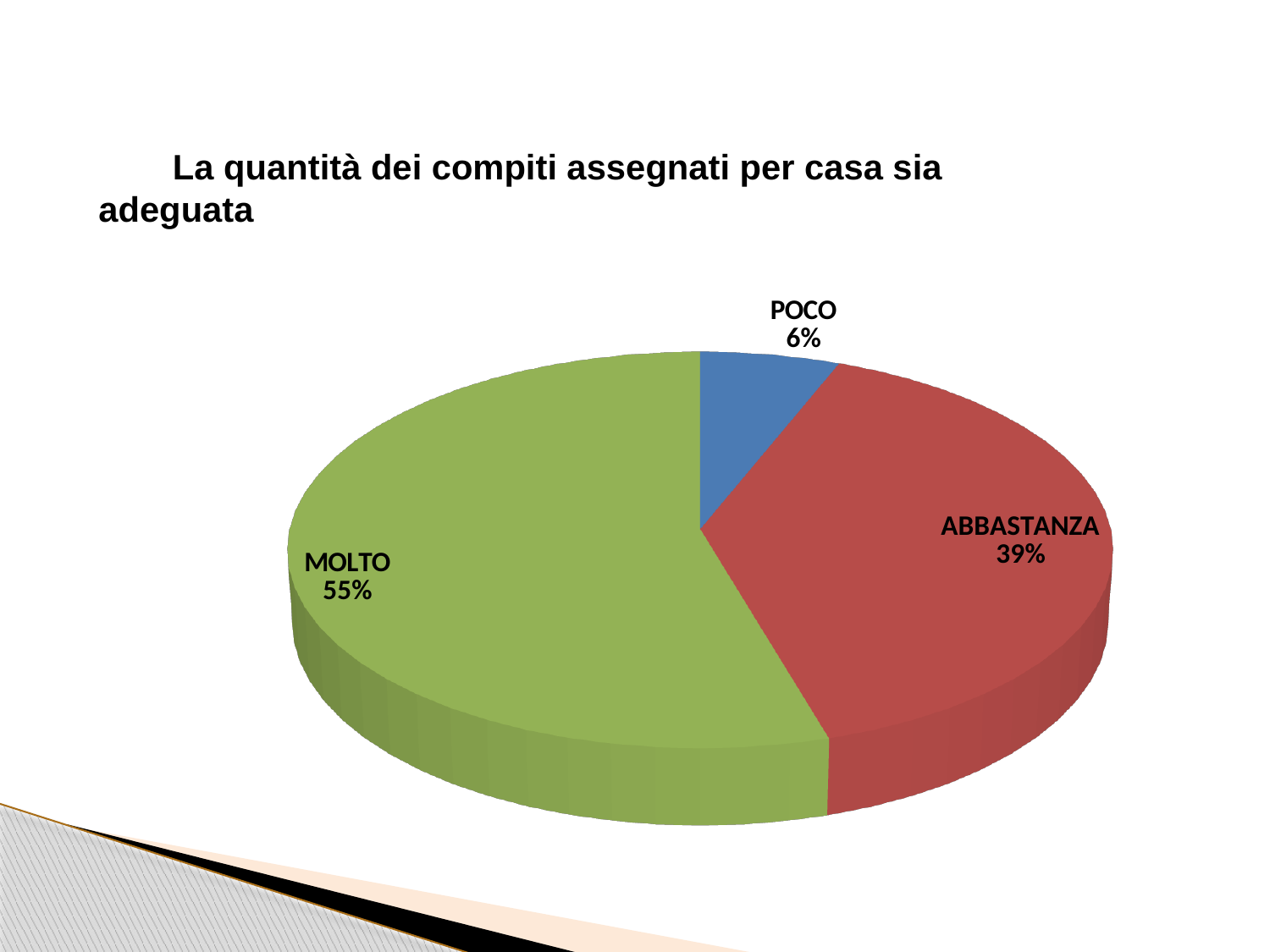
What kind of chart is shown on the slide? Pie chart What colour is the MOLTO slice? Green What is the difference in percentage points between MOLTO and ABBASTANZA? 16 Which is larger, the share for ABBASTANZA or the share for POCO? ABBASTANZA Which category has the smallest slice of the pie? POCO What is the title of the slide above the chart? La quantità dei compiti assegnati per casa sia adeguata What share of the pie does ABBASTANZA represent? 39% What share of the pie does MOLTO represent? 55% How many slices does the pie chart have? 3 What is the difference in percentage points between ABBASTANZA and POCO? 33 Which category has the largest slice of the pie? MOLTO What share of the pie does POCO represent? 6%